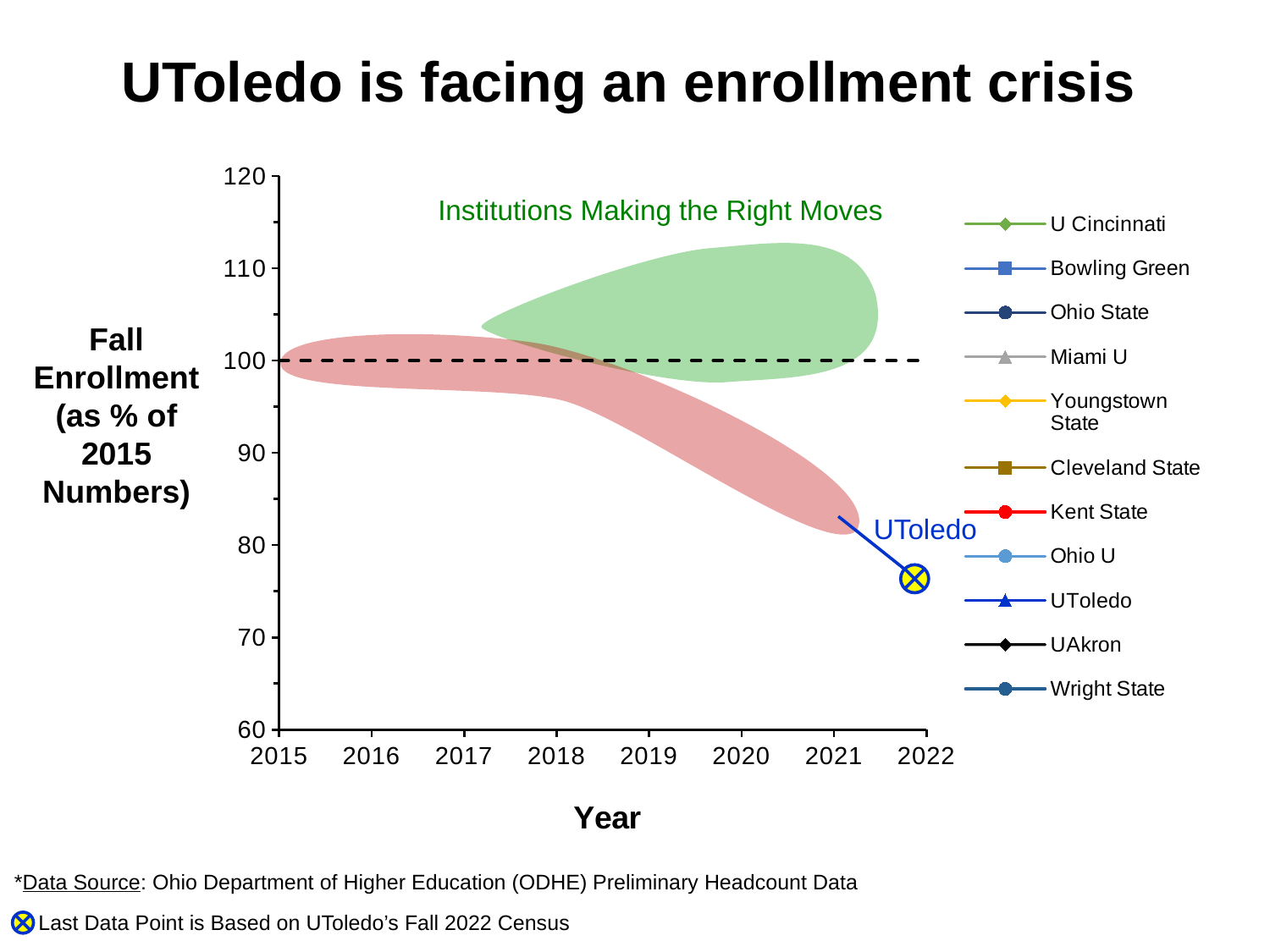
How many years are marked on the x axis? 8 What is the highest value shown on the y axis? 120 What is the first year shown on the x axis? 2015 What label is given to the green shaded region of the chart? Institutions Making the Right Moves What is the label of the x axis? Year Does UToledo's fall enrollment rise or fall from 2015 to 2022? fall Is the value for UToledo in 2022 greater or less than 80? less How many series does the legend list? 11 At what value is the horizontal dashed line drawn? 100 What is the title of the slide's chart? UToledo is facing an enrollment crisis What kind of chart is shown on the slide? line chart Is the value for UToledo in 2022 greater or less than 70? greater